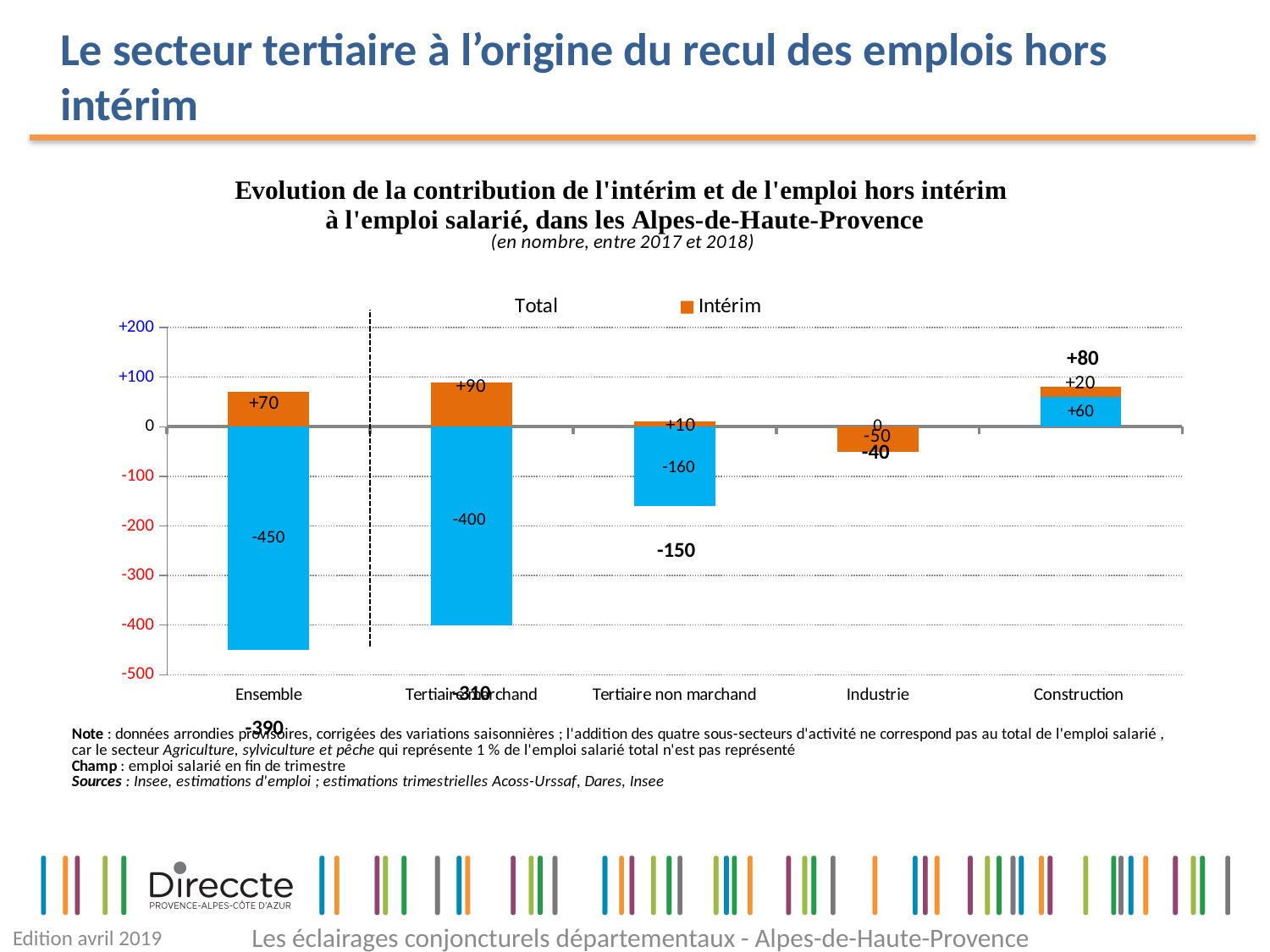
What is the Intérim value for Industrie? -50 Which category has the lowest Intérim value? Industrie Which category has the highest Intérim value? Tertiaire marchand What kind of chart is shown on the slide? Bar chart What is the Total value shown for Construction? +80 How many categories are shown on the x axis? 5 What is the Total value shown for Tertiaire non marchand? -150 What is the value of the blue (non-Intérim) bar for Ensemble? -450 What colour represents the Intérim series? Orange Which has the lower blue-bar value, Tertiaire marchand or Tertiaire non marchand? Tertiaire marchand What is the difference between the Intérim values for Tertiaire marchand and Ensemble? 20 What is the Intérim value for Tertiaire marchand? +90